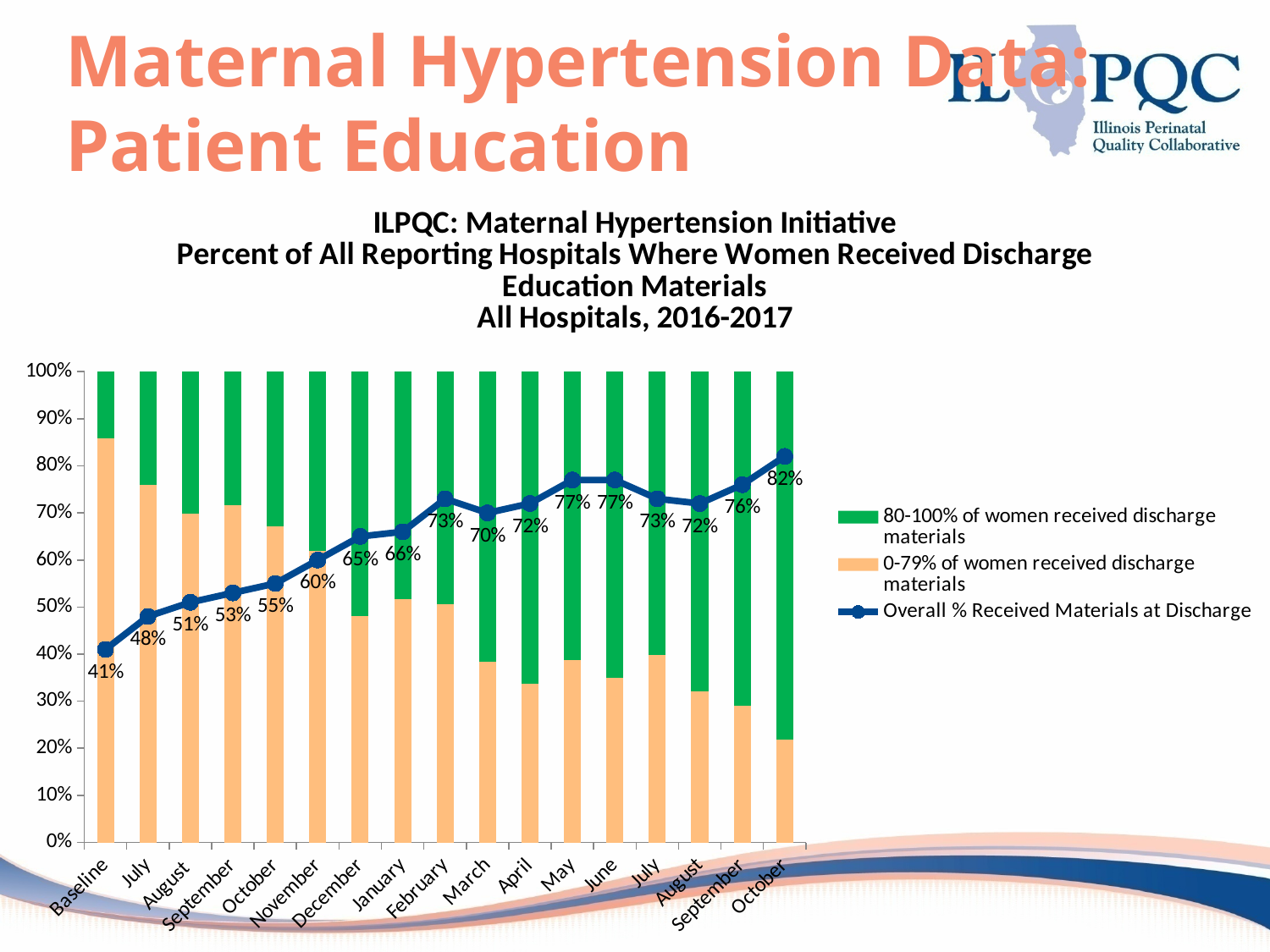
What is the Overall % Received Materials at Discharge value for Baseline? 41% What is the Overall % Received Materials at Discharge value for February? 73% Is the value of the 0-79% of women received discharge materials segment for Baseline greater or less than 80%? greater Does the Overall % Received Materials at Discharge line generally rise or fall from Baseline to the final October? rise Which category has the highest Overall % Received Materials at Discharge value? October (the last category, 82%) How many categories are shown on the x axis? 17 What is the Overall % Received Materials at Discharge value for November? 60% Which has a higher Overall % Received Materials at Discharge value, February or March? February Which category has the lowest Overall % Received Materials at Discharge value? Baseline (41%) How many series does the legend list? 3 What is the difference between the Overall % Received Materials at Discharge value for the final October and for Baseline? 41 percentage points Is the value of the 0-79% of women received discharge materials segment for the final October greater or less than 30%? less